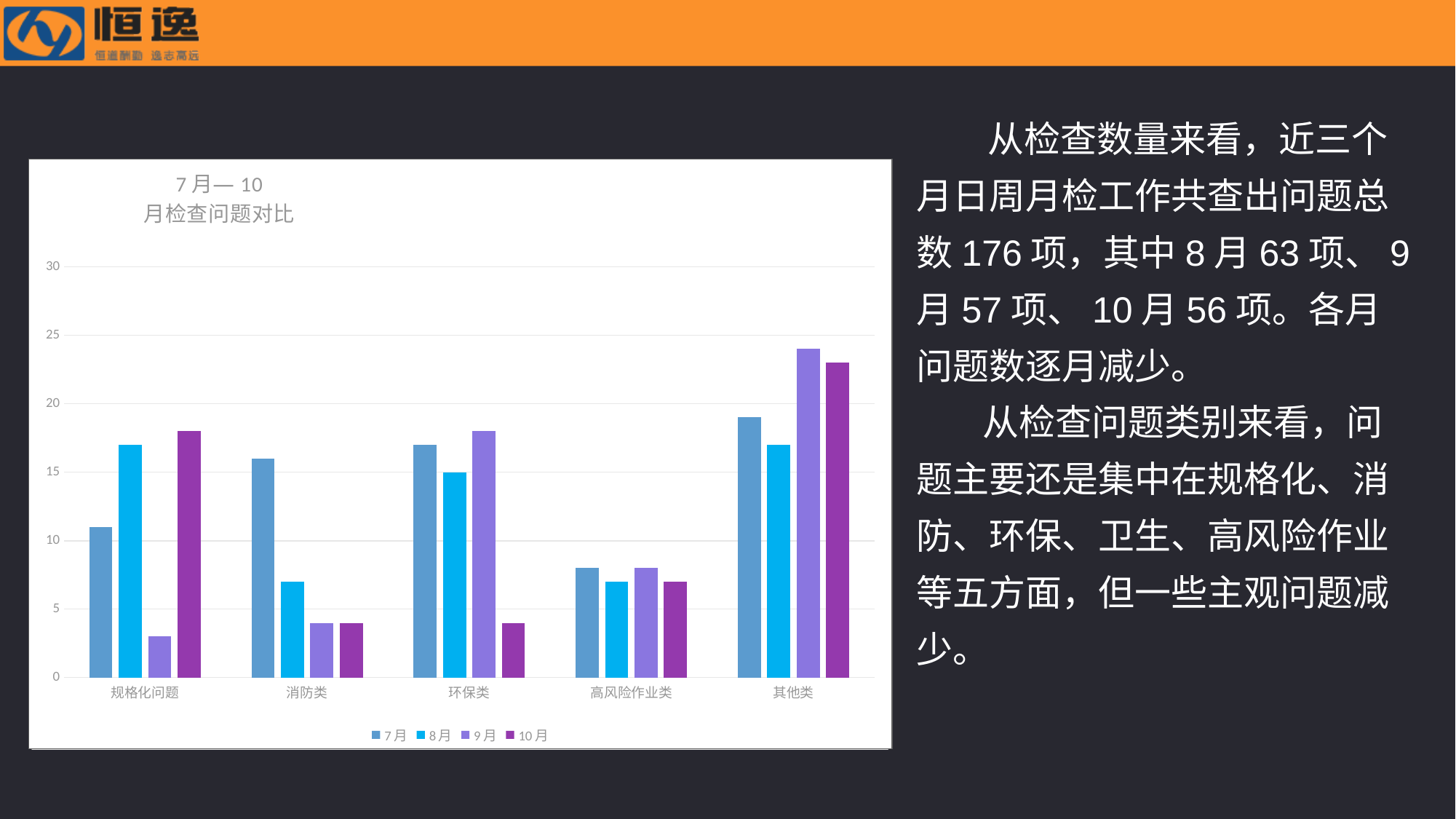
Is the 7月 value for 消防类 greater or less than 10? greater What kind of chart is shown on the slide? bar chart Is the 7月 value for 高风险作业类 greater or less than 10? less Is the 9月 value for 其他类 greater or less than 20? greater For 规格化问题, which is larger: the 7月 value or the 8月 value? 8月 How many series does the chart legend list? 4 Which series are listed in the chart legend? 7月, 8月, 9月, 10月 Which category has the highest 9月 value? 其他类 How many categories are shown on the x axis of the chart? 5 Which category has the lowest 9月 value? 规格化问题